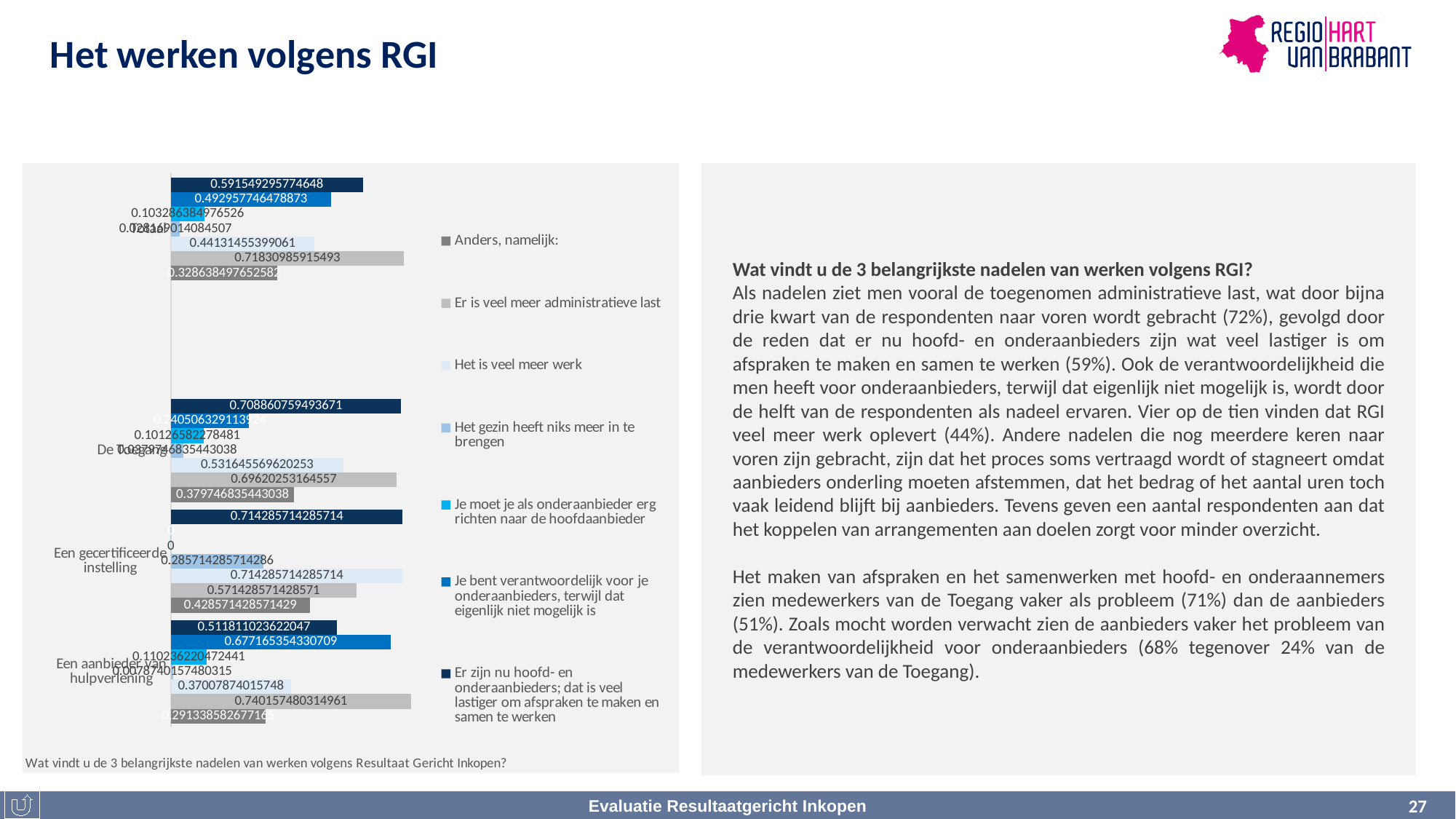
Which series has the highest value for 'Een aanbieder van hulpverlening'? Er is veel meer administratieve last What question is printed below the chart as its caption? Wat vindt u de 3 belangrijkste nadelen van werken volgens Resultaat Gericht Inkopen? Which series has the highest value for 'De Toegang'? Er zijn nu hoofd- en onderaanbieders; dat is veel lastiger om afspraken te maken en samen te werken For 'Een gecertificeerde instelling', what is the difference between the value for 'Het is veel meer werk' and the value for 'Er is veel meer administratieve last'? 0.142857142857143 How many series does the chart legend list? 7 What is the value for 'Er is veel meer administratieve last' for 'Een aanbieder van hulpverlening'? 0.740157480314961 What is the value for 'Er zijn nu hoofd- en onderaanbieders; dat is veel lastiger om afspraken te maken en samen te werken' for 'De Toegang'? 0.708860759493671 What is the value for 'Je bent verantwoordelijk voor je onderaanbieders, terwijl dat eigenlijk niet mogelijk is' for 'Een aanbieder van hulpverlening'? 0.677165354330709 What is the value for 'Het is veel meer werk' for 'De Toegang'? 0.531645569620253 For 'Je bent verantwoordelijk voor je onderaanbieders, terwijl dat eigenlijk niet mogelijk is', which is larger: the value for 'De Toegang' or for 'Een aanbieder van hulpverlening'? Een aanbieder van hulpverlening What kind of chart is shown on the slide? bar chart What is the value for 'Anders, namelijk:' for 'Een gecertificeerde instelling'? 0.428571428571429